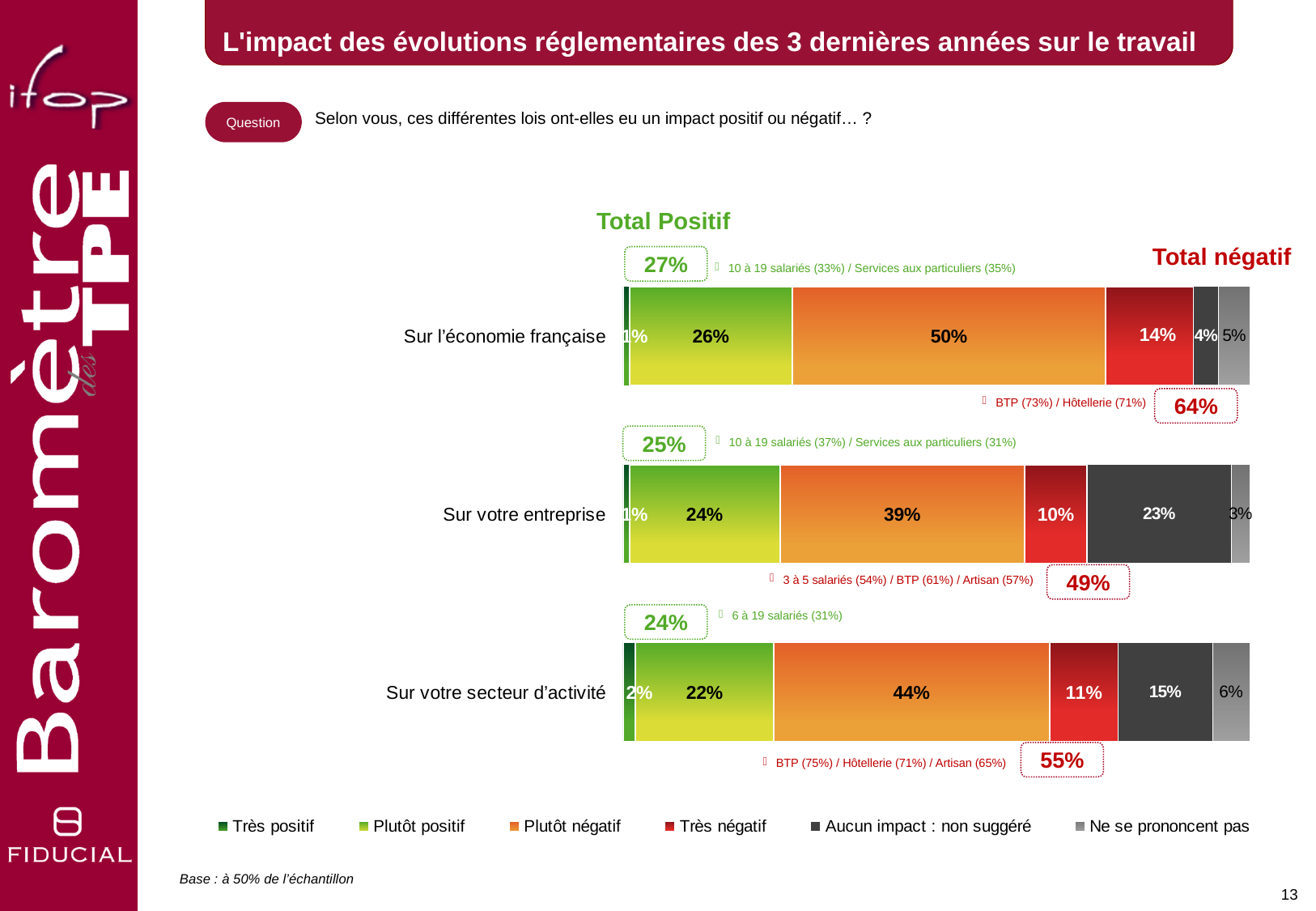
How many categories are plotted on the chart? 3 How many series does the legend list? 6 Which is larger: the 'Aucun impact : non suggéré' value for 'Sur votre secteur d'activité' or for 'Sur l'économie française'? Sur votre secteur d'activité What type of chart is shown on the slide? Stacked bar chart Which category has the highest 'Plutôt négatif' value? Sur l'économie française What is the 'Total négatif' shown for 'Sur votre entreprise'? 49% What is the 'Total Positif' value shown for 'Sur l'économie française'? 27% What is the 'Aucun impact : non suggéré' value for 'Sur votre entreprise'? 23% What is the 'Plutôt négatif' value for 'Sur l'économie française'? 50% Which category has the lowest 'Total Positif' value? Sur votre secteur d'activité What is the 'Plutôt positif' value for 'Sur votre secteur d'activité'? 22% What is the difference between the 'Très négatif' values for 'Sur l'économie française' and 'Sur votre entreprise'? 4%